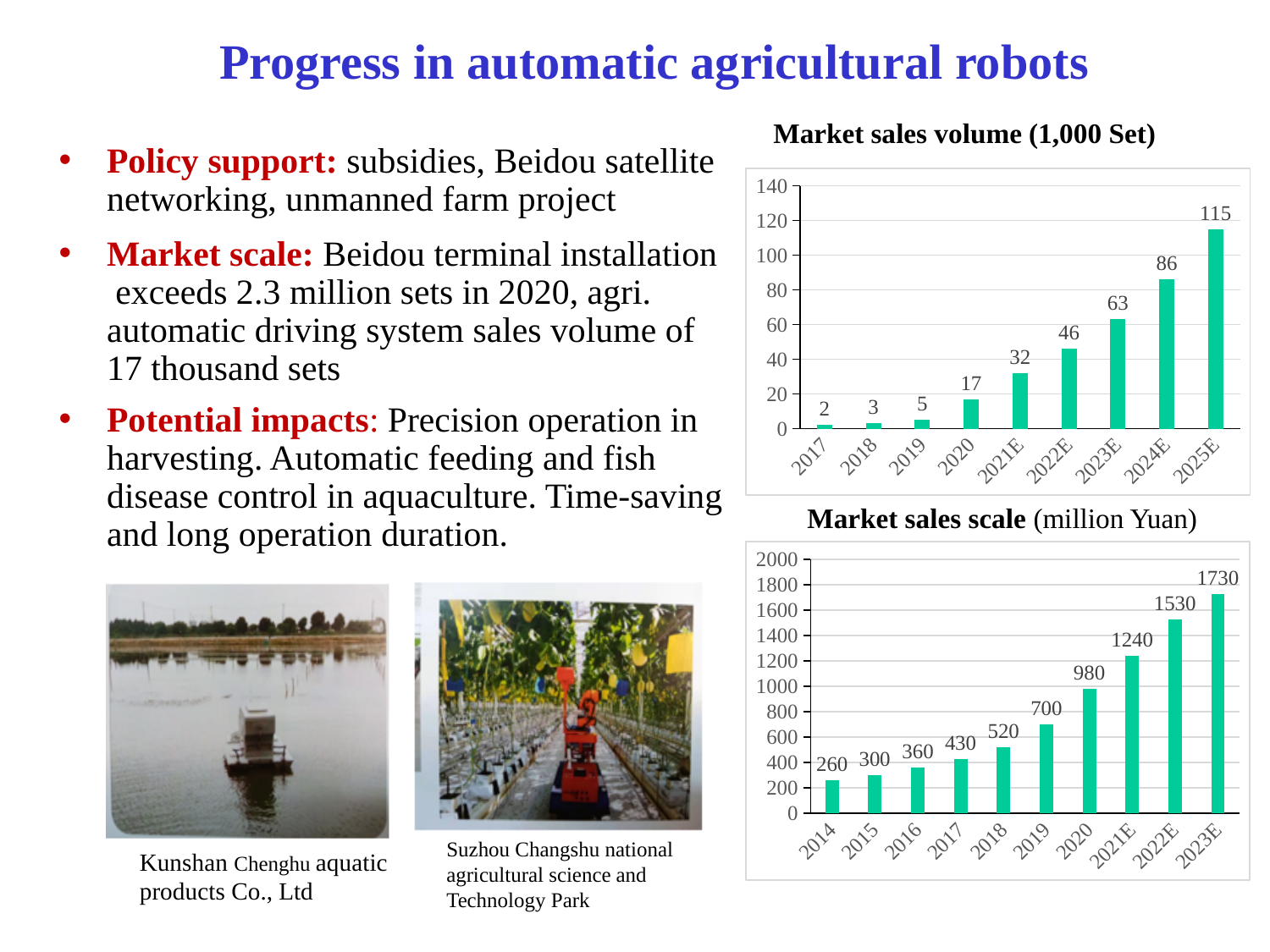
In the 'Market sales volume (1,000 Set)' chart, what is the difference between the values for 2025E and 2024E? 29 In the 'Market sales volume (1,000 Set)' chart, what is the value for 2020? 17 In the 'Market sales volume (1,000 Set)' chart, which year has the lowest value? 2017 In the 'Market sales scale (million Yuan)' chart, how many years are shown on the x axis? 10 In the 'Market sales scale (million Yuan)' chart, what is the value for 2023E? 1730 In the 'Market sales volume (1,000 Set)' chart, which year has the highest value? 2025E In the 'Market sales volume (1,000 Set)' chart, how many years are shown on the x axis? 9 What type of chart is the 'Market sales scale (million Yuan)' chart? bar chart In the 'Market sales volume (1,000 Set)' chart, do the values rise or fall from 2017 to 2025E? rise In the 'Market sales scale (million Yuan)' chart, which is larger, the value for 2016 or the value for 2018? 2018 In the 'Market sales scale (million Yuan)' chart, what is the value for 2019? 700 In the 'Market sales scale (million Yuan)' chart, what is the difference between the values for 2021E and 2020? 260